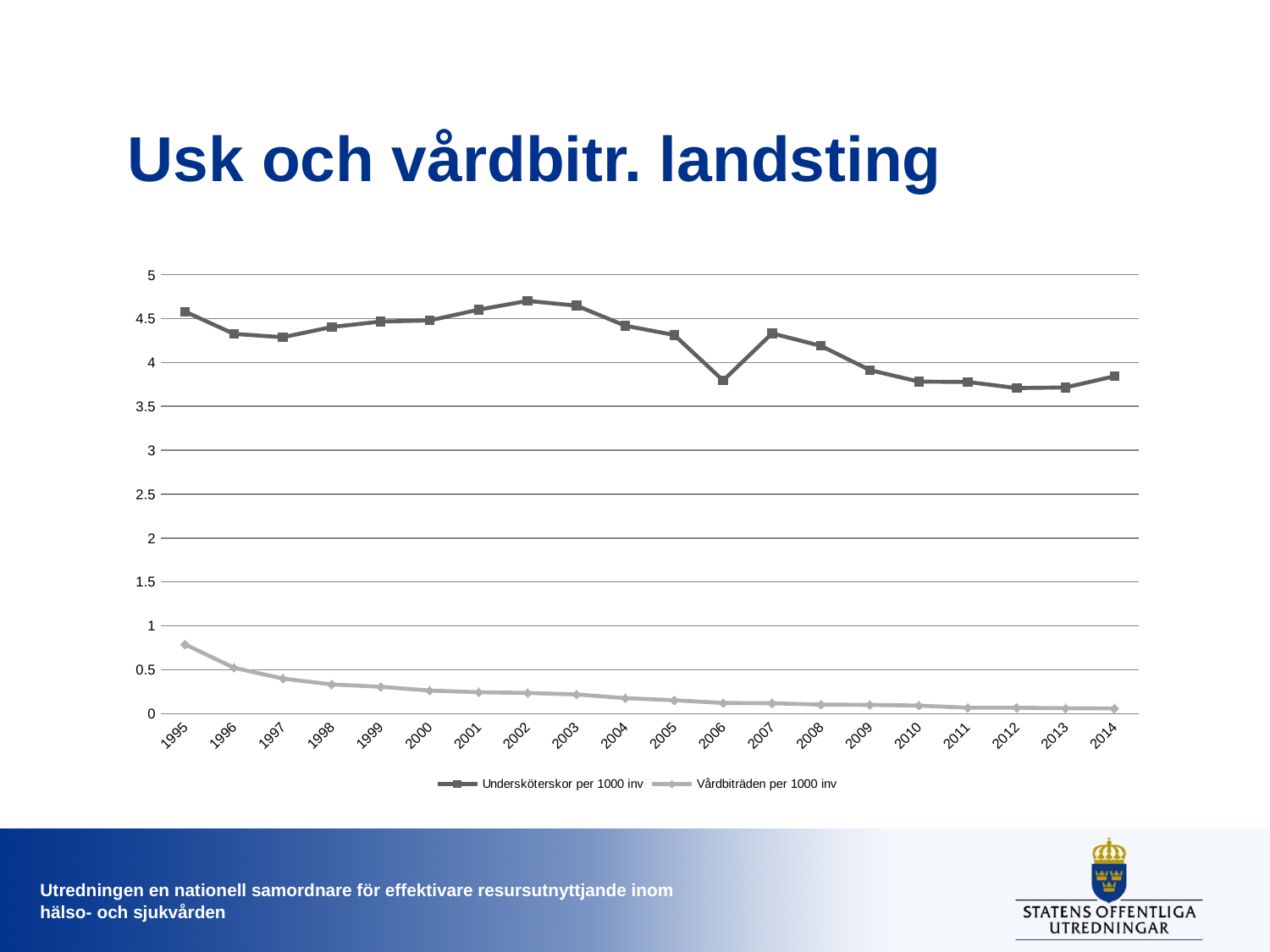
Which two series are listed in the chart legend? Undersköterskor per 1000 inv and Vårdbiträden per 1000 inv Is the value for Undersköterskor per 1000 inv in 2006 greater or less than 4? less Is the value for Undersköterskor per 1000 inv in 2002 greater or less than 4.5? greater In 2010, which series has the larger value: Undersköterskor per 1000 inv or Vårdbiträden per 1000 inv? Undersköterskor per 1000 inv Is the value for Vårdbiträden per 1000 inv in 1995 greater or less than 0.5? greater In which year is the value for Vårdbiträden per 1000 inv highest? 1995 How many series does the chart legend list? 2 What kind of chart is shown on the slide? Line chart What is the title of the slide containing the chart? Usk och vårdbitr. landsting Does the value for Vårdbiträden per 1000 inv rise or fall from 1995 to 2014? fall How many years are plotted along the x axis of the chart? 20 Which is larger for Undersköterskor per 1000 inv: the value in 2002 or the value in 2006? 2002